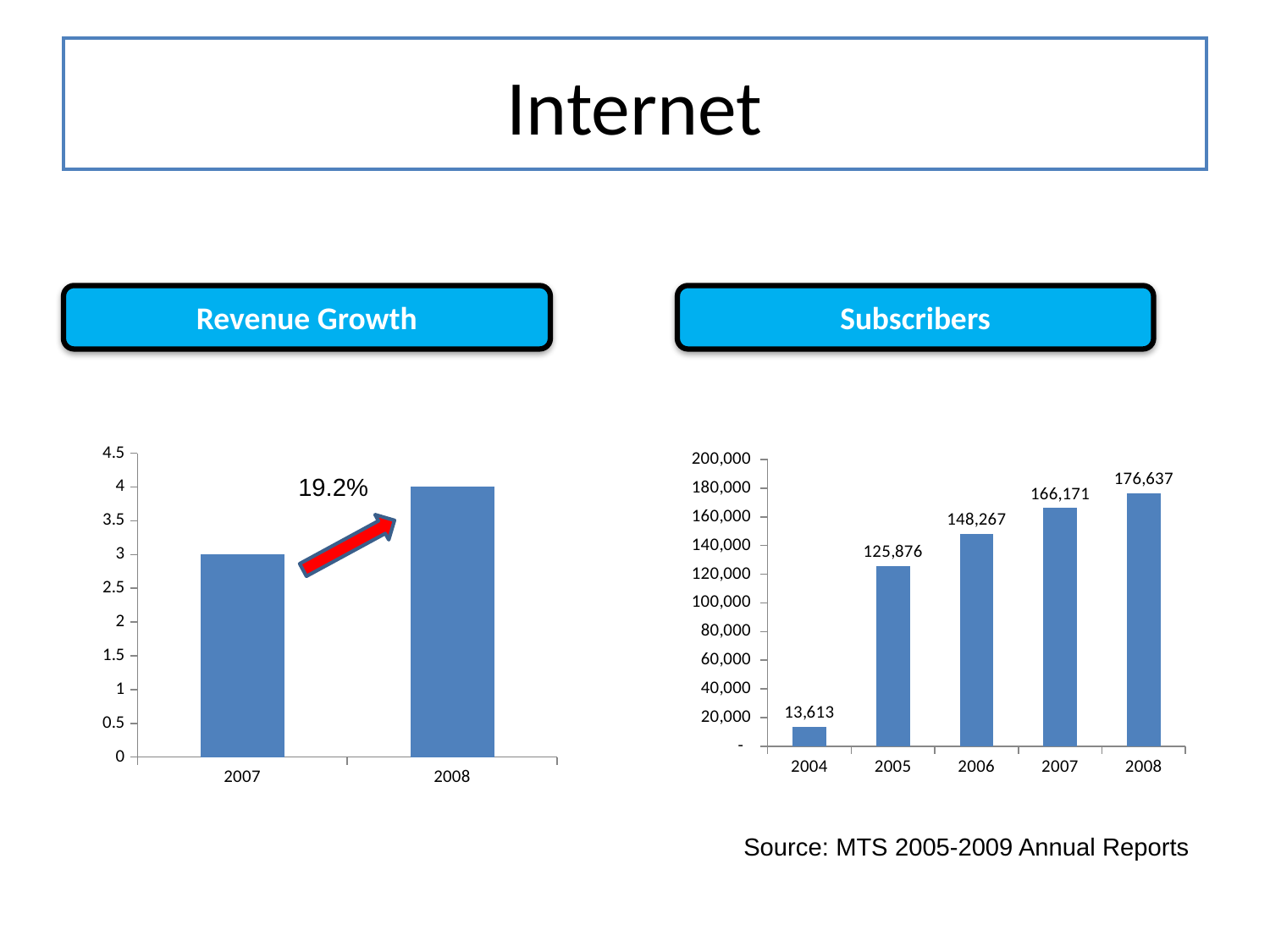
In the Subscribers chart, how many years are shown on the x axis? 5 In the Revenue Growth chart, what percentage is printed next to the arrow between the 2007 and 2008 bars? 19.2% In the Subscribers chart, which year has the highest value? 2008 In the Revenue Growth chart, what is the value for 2008? 4 In the Subscribers chart, which year has the lowest value? 2004 In the Subscribers chart, which is larger, the value for 2005 or the value for 2006? 2006 In the Subscribers chart, do the values rise or fall from 2004 to 2008? rise In the Subscribers chart, what is the value for 2004? 13,613 In the Subscribers chart, what is the value for 2006? 148,267 In the Revenue Growth chart, what is the value for 2007? 3 What kind of chart is the Revenue Growth chart? bar chart In the Subscribers chart, what is the difference between the 2008 and 2007 values? 10,466